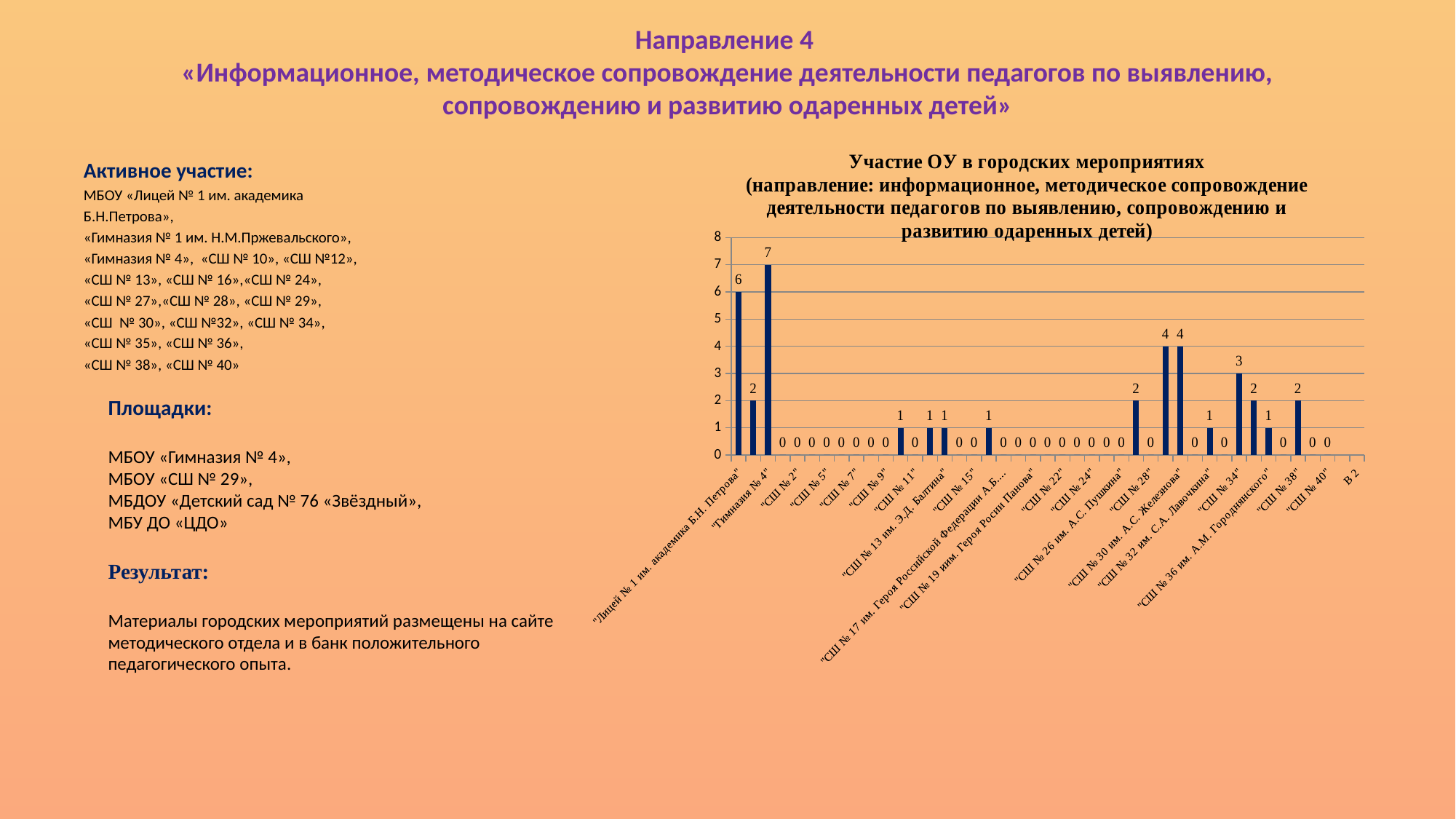
What is the difference between the values for "Гимназия № 4" and "Лицей № 1 им. академика Б.Н. Петрова"? 1 Is the value for "Лицей № 1 им. академика Б.Н. Петрова" greater or less than 5? greater What is the value for "Лицей № 1 им. академика Б.Н. Петрова"? 6 What type of chart is shown on the slide? bar chart Which category has the highest value in the chart? "Гимназия № 4" What is the value for "СШ № 30 им. А.С. Железнова"? 4 What is the value for "СШ № 38"? 2 What is the highest value shown in the chart? 7 Which is larger, the value for "Лицей № 1 им. академика Б.Н. Петрова" or for "Гимназия № 4"? "Гимназия № 4" What is the maximum value shown on the vertical axis of the chart? 8 What is the value for "Гимназия № 4"? 7 What is the value for "СШ № 34"? 3